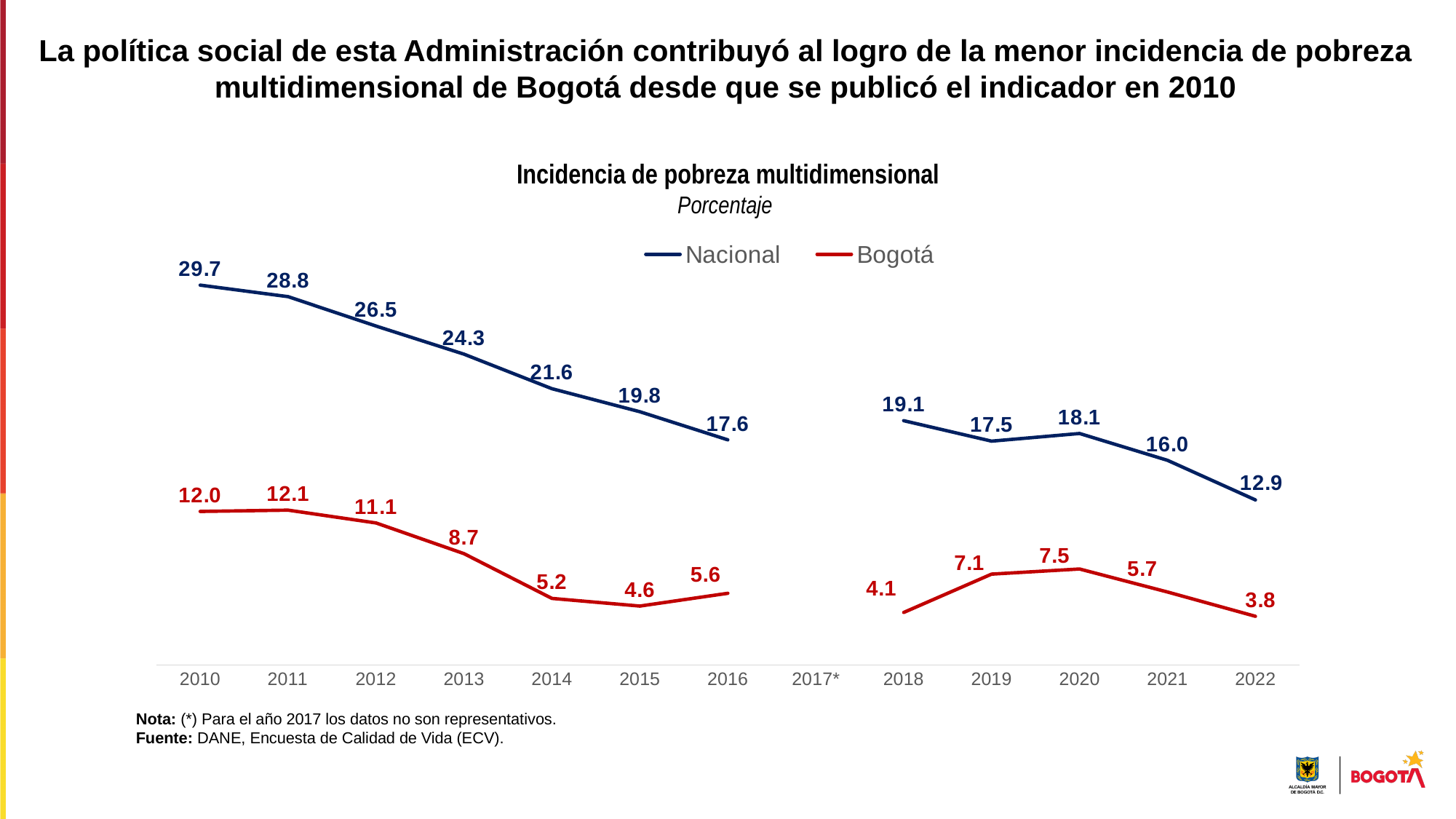
What type of chart is shown on the slide? Line chart What is the Nacional value for 2020? 18.1 In which year is the Bogotá value lowest? 2022 What is the Bogotá value for 2022? 3.8 In which year is the Nacional value highest? 2010 Which year on the x axis is marked with an asterisk because its data are not representative? 2017* What is the Bogotá value for 2015? 4.6 Which is larger, the Bogotá value in 2019 or in 2020? 2020 Does the Nacional series generally rise or fall from 2010 to 2022? Fall What is the Nacional value for 2010? 29.7 What is the difference between the Nacional and Bogotá values in 2022? 9.1 How many series does the legend list? 2